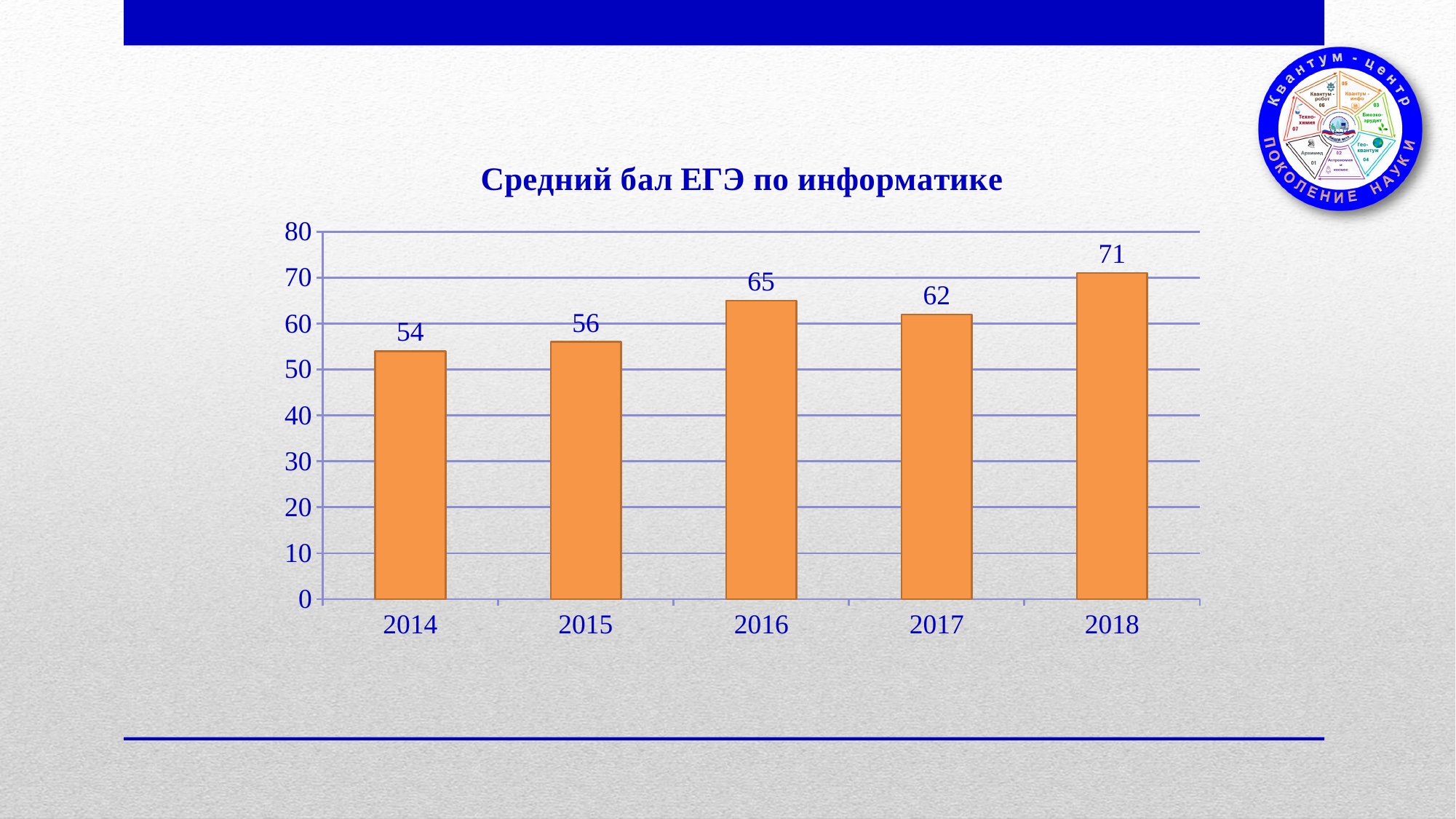
How many years are shown on the x axis? 5 What is the value for 2014? 54 What is the title of the chart? Средний бал ЕГЭ по информатике Which year has the highest value? 2018 What is the difference between the values for 2018 and 2014? 17 What is the value for 2018? 71 What is the difference between the values for 2016 and 2017? 3 Which is larger, the value for 2016 or the value for 2017? 2016 Is the value for 2015 greater or less than 60? less What is the value for 2016? 65 Which year has the lowest value? 2014 What kind of chart is shown on the slide? bar chart